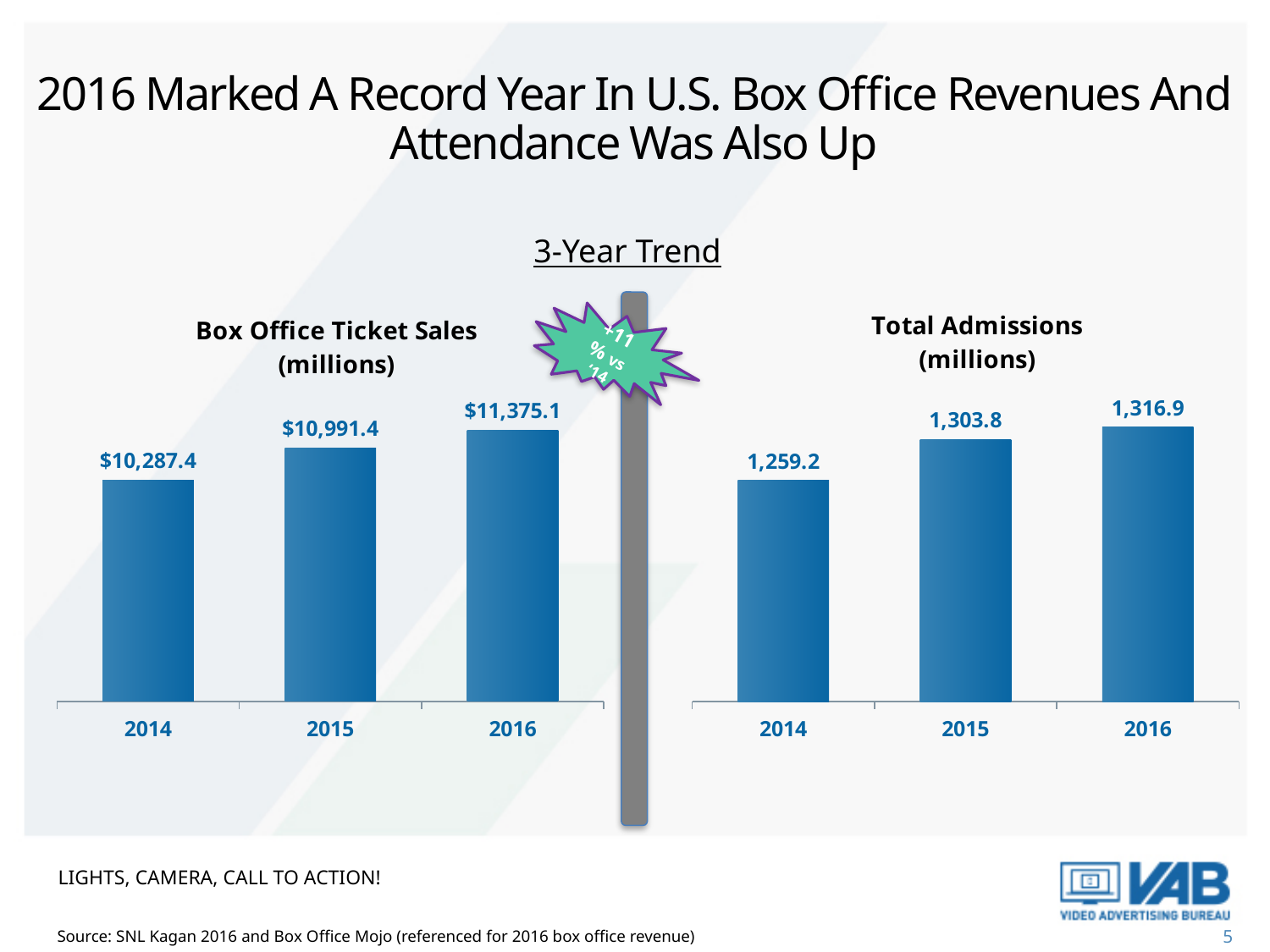
In the Box Office Ticket Sales chart, what is the value for 2016? $11,375.1 In the Box Office Ticket Sales chart, what is the difference between the 2016 and 2014 values? $1,087.7 How many years are shown in the Total Admissions chart? 3 What kind of chart is the Box Office Ticket Sales chart? Bar chart In the Total Admissions chart, what is the value for 2016? 1,316.9 In the Box Office Ticket Sales chart, which year has the highest value? 2016 In the Total Admissions chart, which year has the lowest value? 2014 In the Box Office Ticket Sales chart, which is larger, the value for 2015 or the value for 2014? 2015 In the Total Admissions chart, do the values rise or fall from 2014 to 2016? Rise In the Box Office Ticket Sales chart, what is the value for 2014? $10,287.4 In the Total Admissions chart, what is the value for 2015? 1,303.8 In the Total Admissions chart, what is the difference between the 2016 and 2014 values? 57.7